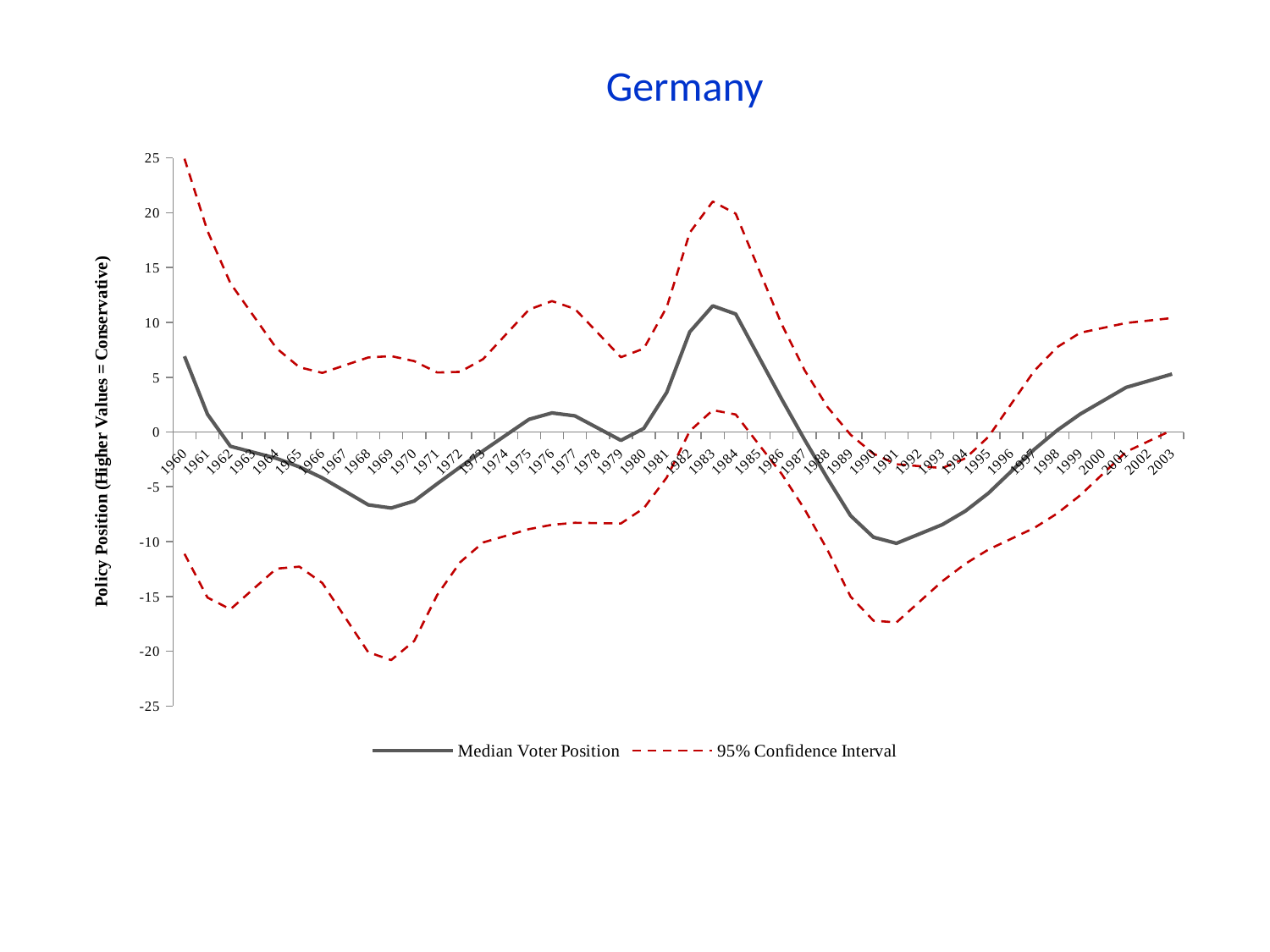
Is the Median Voter Position in 1969 greater or less than -5? less Is the Median Voter Position in 1960 greater or less than 5? greater Is the Median Voter Position in 1990 greater or less than -5? less In which year does the Median Voter Position reach its highest value? 1983 What is the title of the chart? Germany What kind of chart is shown on the slide? line chart How many years are plotted along the x axis? 44 How many series does the legend list? 2 Which year has the larger Median Voter Position, 1969 or 1976? 1976 What is the label of the y axis? Policy Position (Higher Values = Conservative) Does the Median Voter Position rise or fall from 1984 to 1990? fall